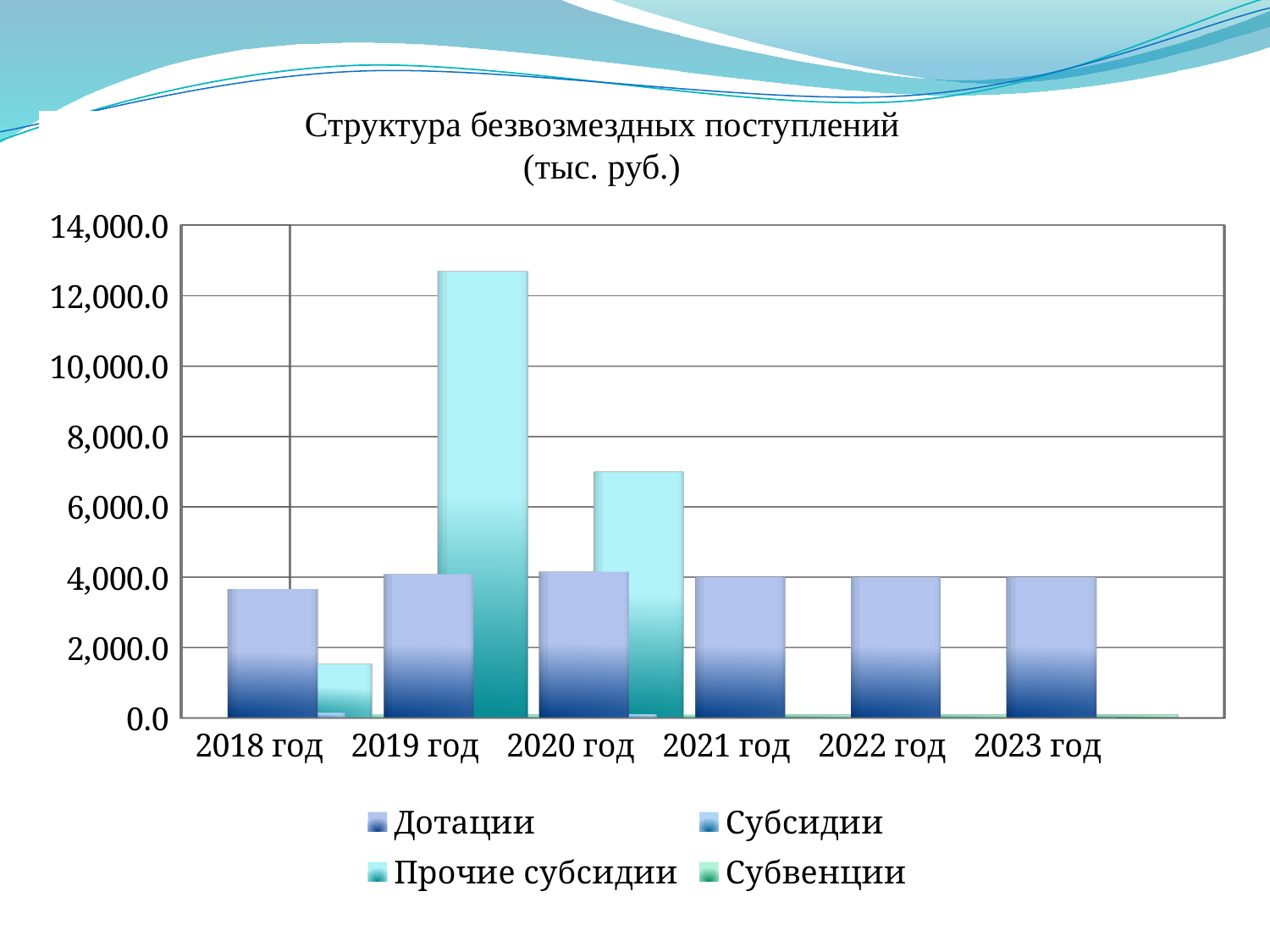
Is the value for Дотации in 2018 год greater or less than 4,000.0? less Is the value for Прочие субсидии in 2019 год greater or less than 12,000.0? greater Which is larger in 2018 год: Дотации or Прочие субсидии? Дотации What is the title of the chart? Структура безвозмездных поступлений (тыс. руб.) Which is larger: Прочие субсидии in 2019 год or Прочие субсидии in 2020 год? 2019 год Is the value for Прочие субсидии in 2018 год greater or less than 2,000.0? less Which series is shown in the legend immediately after Дотации? Субсидии What kind of chart is shown on the slide? bar chart In which year is the value for Прочие субсидии the highest? 2019 год How many year categories are shown on the x axis? 6 How many series does the legend list? 4